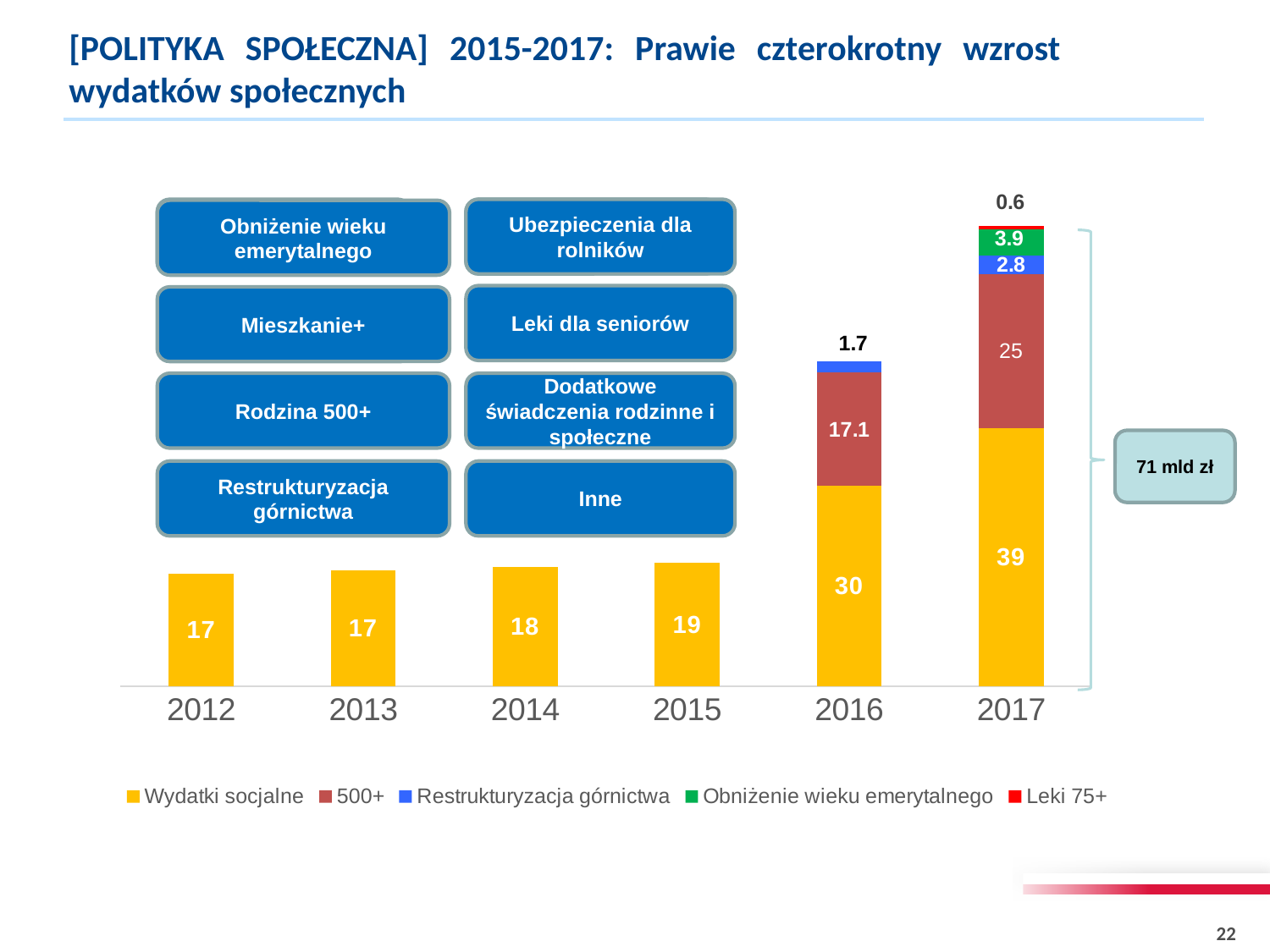
What kind of chart is shown on the slide? Stacked bar chart What is the value of the 500+ segment for 2016? 17.1 What is the total of the stacked bar for 2016? 48.8 Which is larger, the Restrukturyzacja górnictwa value for 2016 or for 2017? 2017 What is the value of Wydatki socjalne for 2017? 39 Which year has the highest value of Wydatki socjalne? 2017 How many years are shown on the x axis? 6 How many series does the legend list? 5 What is the value of Wydatki socjalne for 2012? 17 What is the value of the Leki 75+ segment for 2017? 0.6 What is the value of the Obniżenie wieku emerytalnego segment for 2017? 3.9 What is the difference between the 500+ values for 2017 and 2016? 7.9